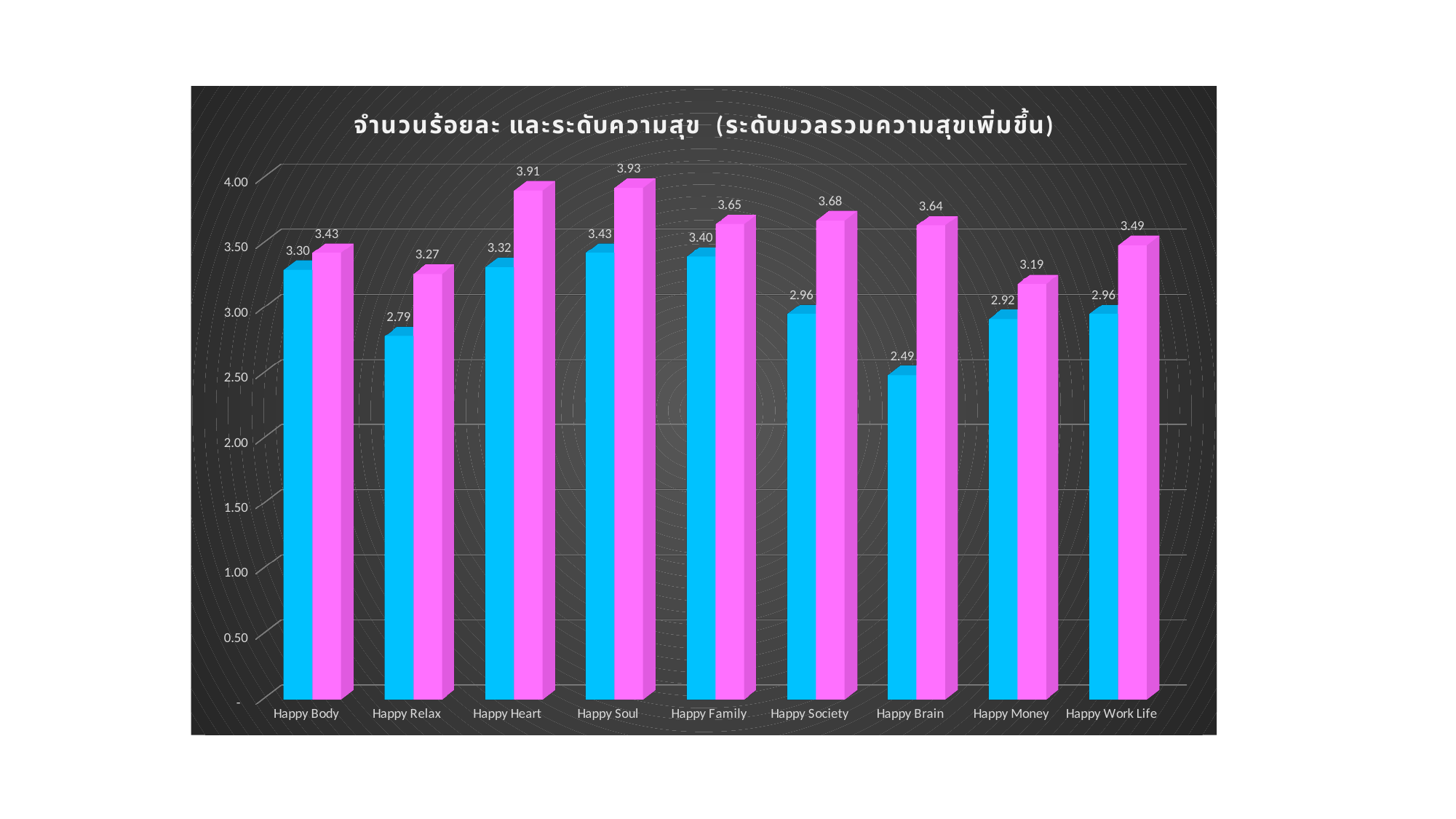
What is the value of the blue bar for Happy Brain? 2.49 Which category has the lowest pink bar? Happy Money What two colours are used for the bars in the chart? blue and pink Which category has the highest pink bar? Happy Soul What is the value of the pink bar for Happy Work Life? 3.49 What is the difference between the pink and blue bars for Happy Brain? 1.15 Which category has the lowest blue bar? Happy Brain What is the value of the blue bar for Happy Relax? 2.79 What kind of chart is shown on the slide? bar chart How many categories are shown on the x axis? 9 Which is larger for Happy Society: the blue bar or the pink bar? the pink bar What is the value of the pink bar for Happy Heart? 3.91